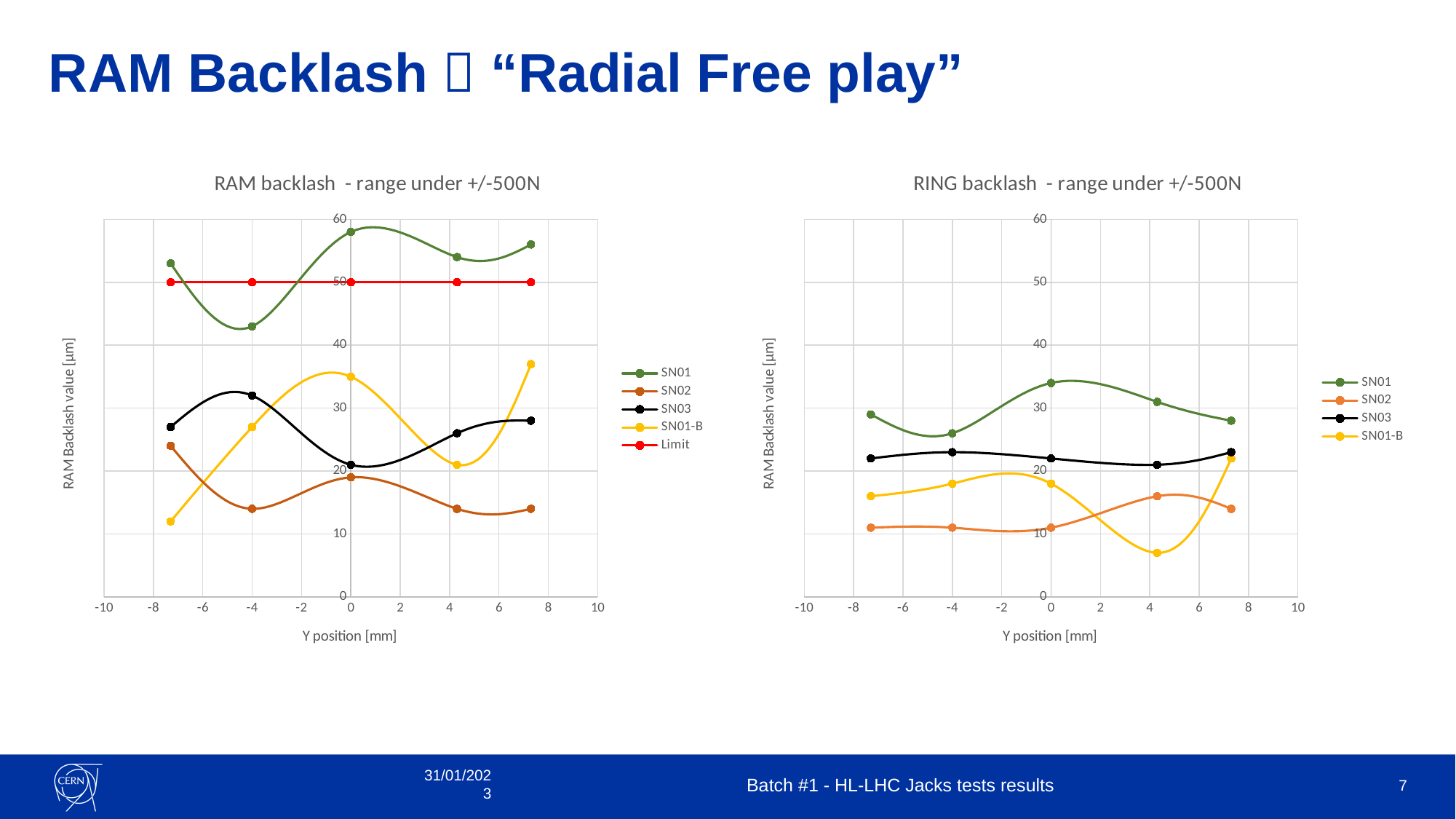
In the 'RAM backlash - range under +/-500N' chart, is the SN02 value at Y position -4 greater or less than 20? less In the 'RAM backlash - range under +/-500N' chart, what constant value does the Limit series sit at? 50 In the 'RAM backlash - range under +/-500N' chart, is the SN01 value at Y position 0 greater or less than 50? greater What kind of chart is the 'RAM backlash - range under +/-500N' chart? line chart In the 'RING backlash - range under +/-500N' chart, at the leftmost Y position, which is larger: SN01 or SN03? SN01 In the 'RING backlash - range under +/-500N' chart, which series reaches the lowest value? SN01-B How many series does the legend of the 'RING backlash - range under +/-500N' chart list? 4 In the 'RING backlash - range under +/-500N' chart, is the SN01 value at Y position 0 greater or less than 30? greater In the 'RAM backlash - range under +/-500N' chart, at Y position 0, which is larger: SN03 or SN01-B? SN01-B In the 'RAM backlash - range under +/-500N' chart, which series has the highest values? SN01 How many data points does the SN01 series have in the 'RING backlash - range under +/-500N' chart? 5 How many series does the legend of the 'RAM backlash - range under +/-500N' chart list? 5